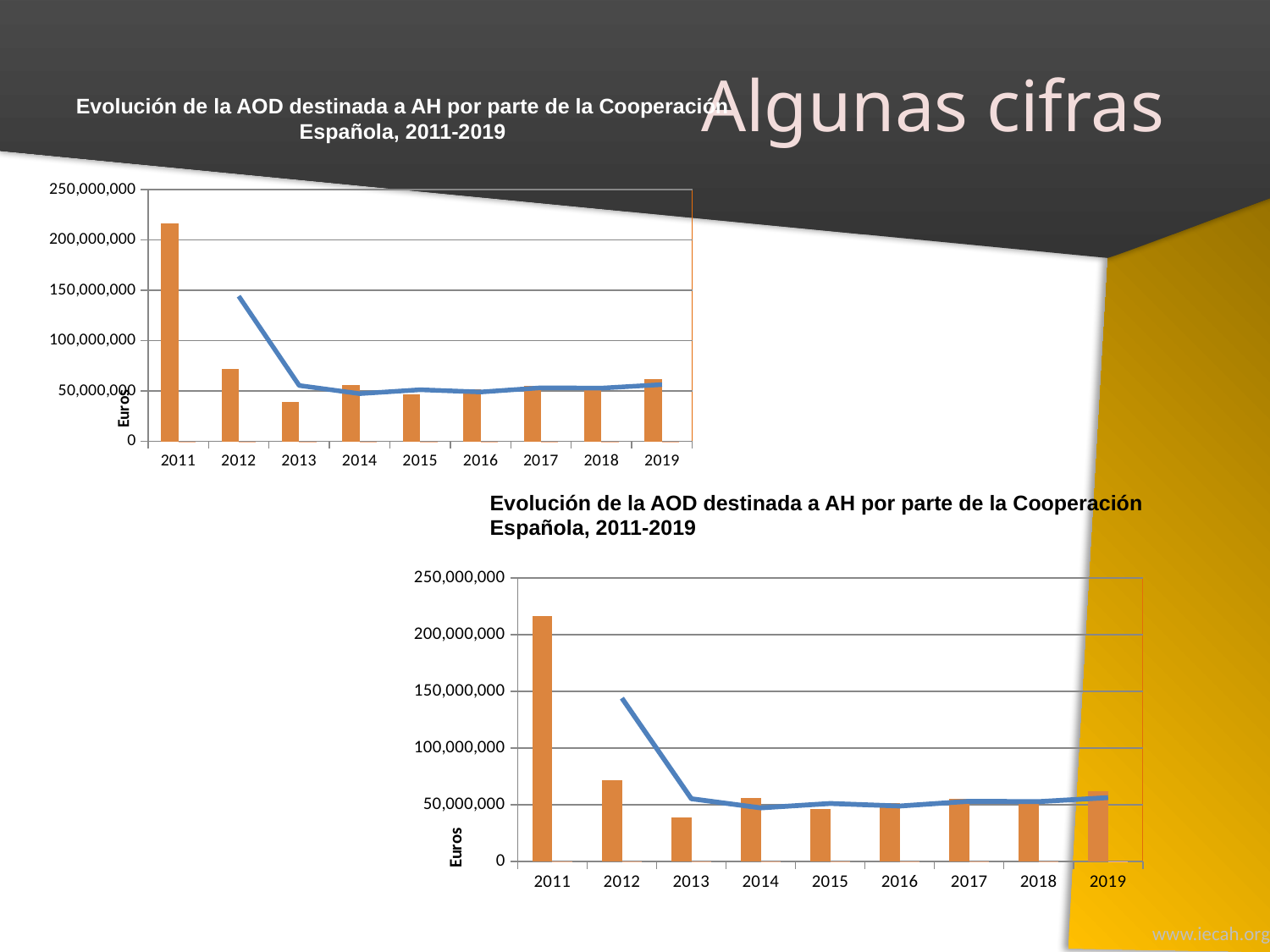
In the top-left chart, which bar is taller, 2011 or 2012? 2011 In the top-left chart, do the bar values rise or fall from 2011 to 2013? fall In the top-left chart, is the bar for 2011 greater or less than 200,000,000? greater In the top-left chart, is the bar for 2013 greater or less than 50,000,000? less In the top-left chart, which year has the lowest bar? 2013 In the top-left chart, what kind of chart is used to show the yearly values? bar chart with a line In the bottom-right chart, which year has the highest bar? 2011 In the bottom-right chart, is the bar for 2012 greater or less than 50,000,000? greater What is the title of the bottom-right chart? Evolución de la AOD destinada a AH por parte de la Cooperación Española, 2011-2019 In the top-left chart, which year has the highest bar? 2011 In the bottom-right chart, what is the label on the vertical axis? Euros In the top-left chart, how many years are shown on the x axis? 9